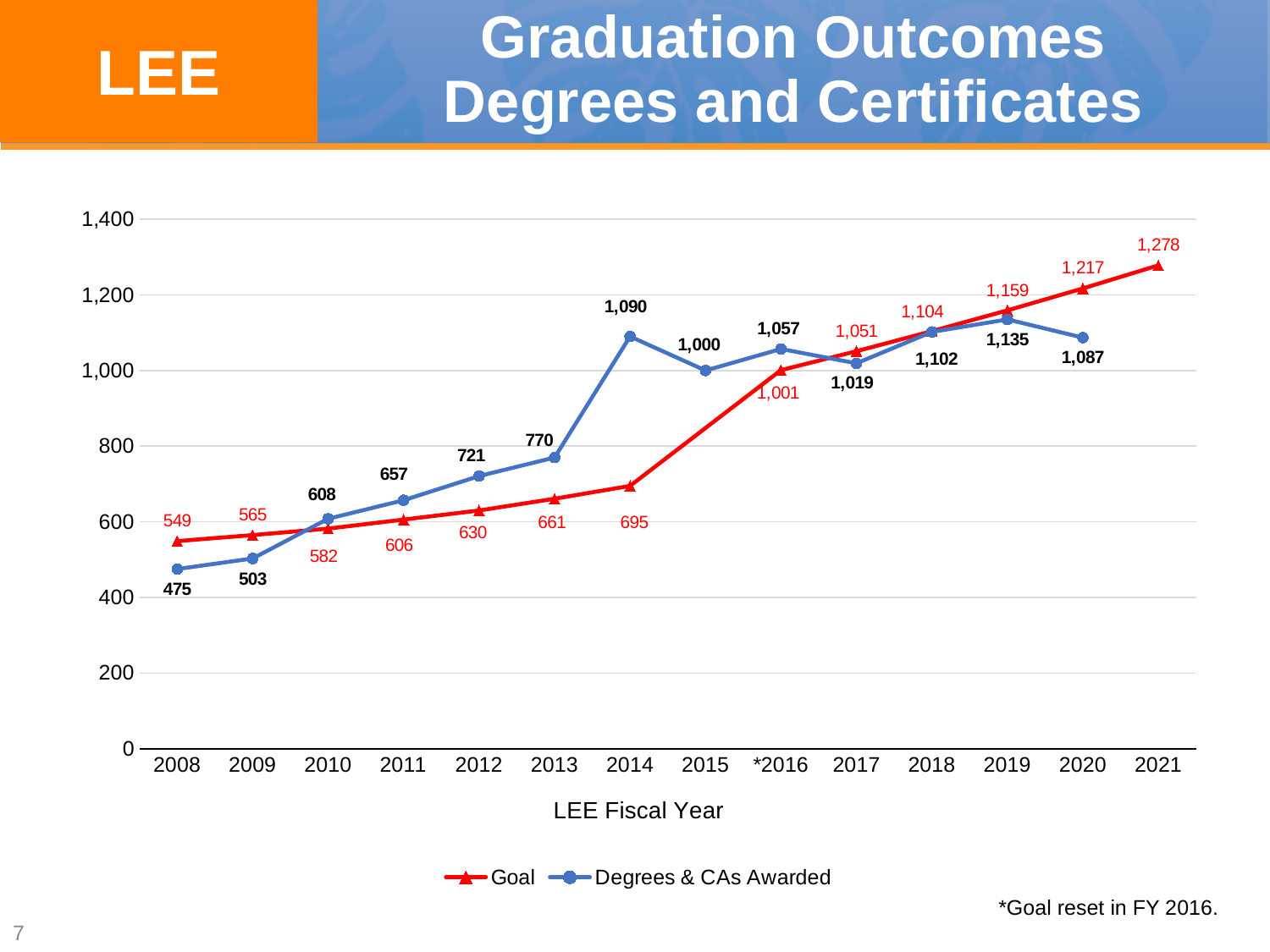
How many series does the legend list? 2 In which year is the Degrees & CAs Awarded value highest? 2019 Does the Goal line rise or fall from 2008 to 2021? Rises How many Degrees & CAs were awarded in 2014? 1,090 What kind of chart is shown on the slide? Line chart Is the Degrees & CAs Awarded value for 2013 greater or less than 800? less How many Degrees & CAs were awarded in 2020? 1,087 In which year is the Degrees & CAs Awarded value lowest? 2008 What is the Goal value for 2021? 1,278 What is the Goal value for 2008? 549 What is the difference between the Goal and the Degrees & CAs Awarded in 2020? 130 Which is larger in 2014, the Goal or the Degrees & CAs Awarded? Degrees & CAs Awarded